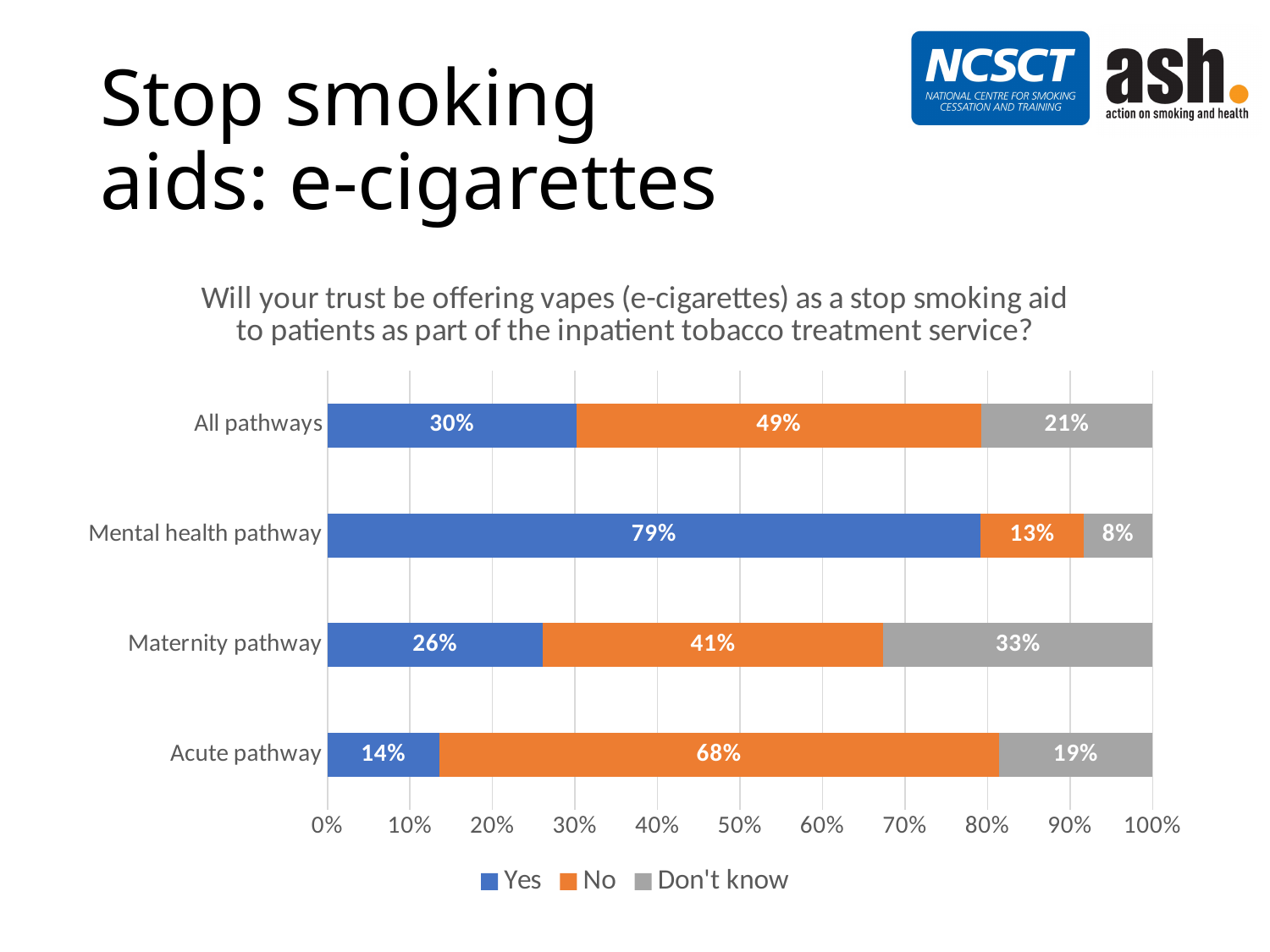
Which colour represents the No responses in the chart? Orange What is the Yes value for All pathways? 30% How many pathway categories are shown on the chart? 4 What is the difference between the No percentage for the Acute pathway and the No percentage for the Maternity pathway? 27% What percentage of the Acute pathway answered No? 68% Which is larger: the Don't know value for All pathways or the Don't know value for the Acute pathway? All pathways How many series does the legend list? 3 Which pathway has the highest Yes percentage? Mental health pathway What percentage of the Mental health pathway answered Yes? 79% What kind of chart is shown on the slide? Stacked bar chart What is the Don't know value for the Maternity pathway? 33% Which pathway has the lowest Yes percentage? Acute pathway